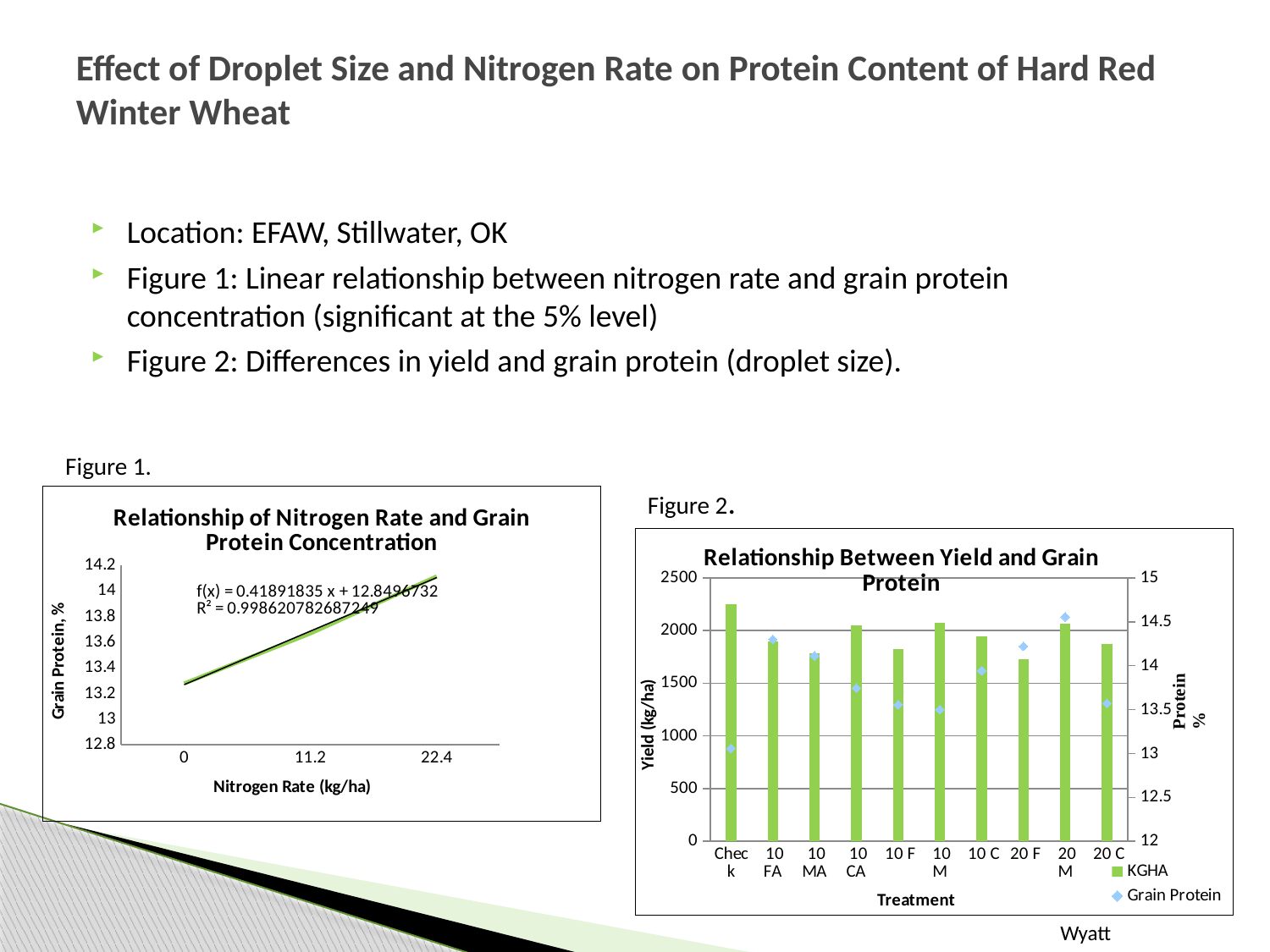
In Figure 2, how many treatments are shown on the x axis? 10 In Figure 2, how many series does the legend list? 2 In Figure 1, what R² value is printed on the chart? R² = 0.998620782687249 In Figure 2, which treatment has the lowest Grain Protein point? Check In Figure 2, which has the larger yield (KGHA) bar, 10 CA or 10 F? 10 CA In Figure 1, does grain protein rise or fall as nitrogen rate increases along the x axis? rise In Figure 2, is the yield (KGHA) for 20 F greater or less than 2000? less In Figure 1, what kind of chart is shown? line chart In Figure 2, which treatment has the highest Grain Protein point? 20 M In Figure 2, which treatment has the highest yield (KGHA) bar? Check In Figure 2, is the yield (KGHA) for Check greater or less than 2000? greater In Figure 1, what is the title of the chart? Relationship of Nitrogen Rate and Grain Protein Concentration